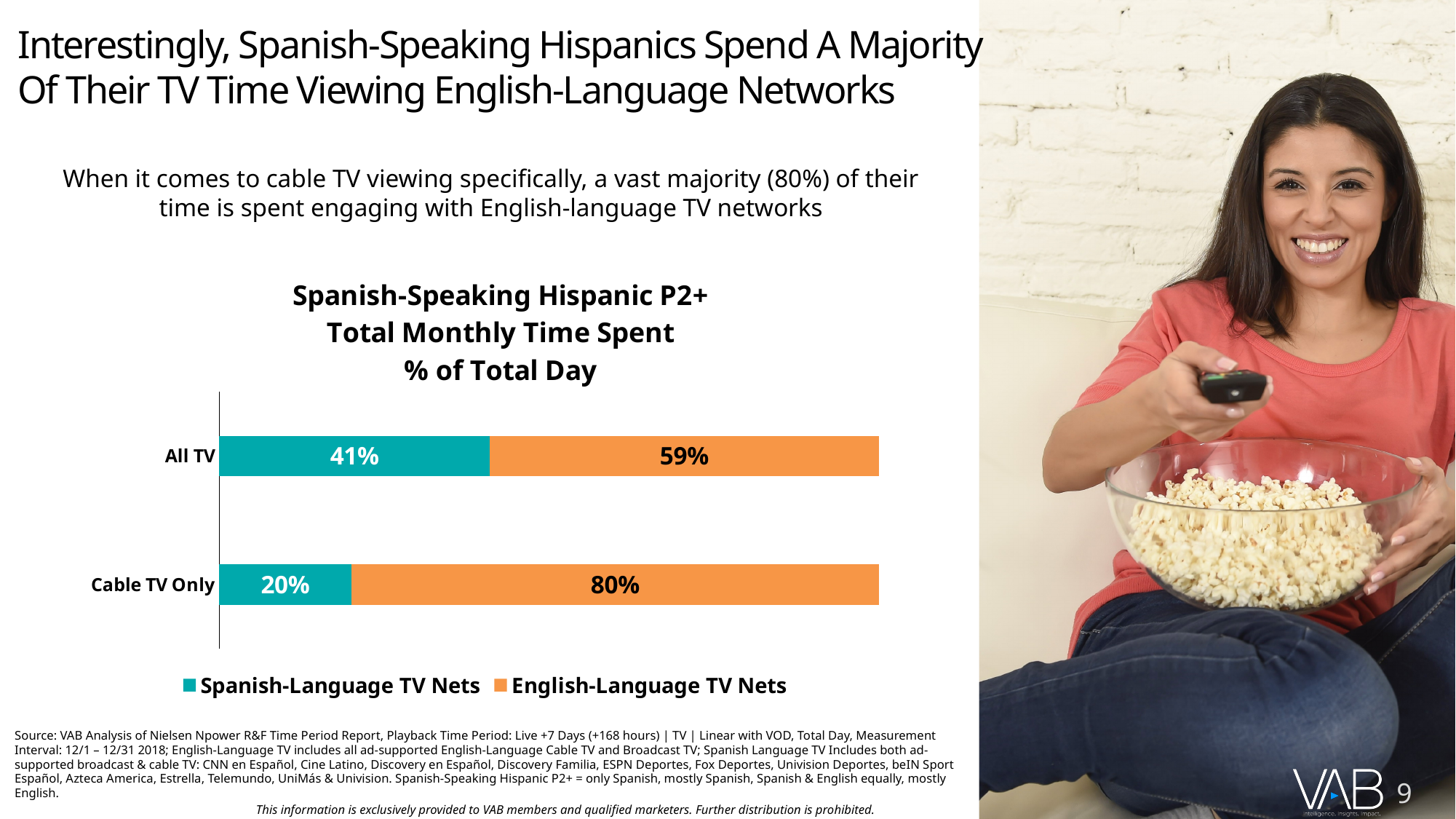
Which category has the higher English-Language TV Nets share, All TV or Cable TV Only? Cable TV Only What is the English-Language TV Nets value for Cable TV Only? 80% What is the Spanish-Language TV Nets value for Cable TV Only? 20% What is the total of the stacked bar for All TV? 100% What is the Spanish-Language TV Nets value for All TV? 41% What is the difference between the Spanish-Language TV Nets values for All TV and Cable TV Only? 21% How many series does the legend list? 2 What is the English-Language TV Nets value for All TV? 59% How many categories are shown on the chart? 2 What kind of chart is shown on the slide? Stacked bar chart What is the difference between the English-Language and Spanish-Language TV Nets values for Cable TV Only? 60% Which category has the lowest Spanish-Language TV Nets value? Cable TV Only